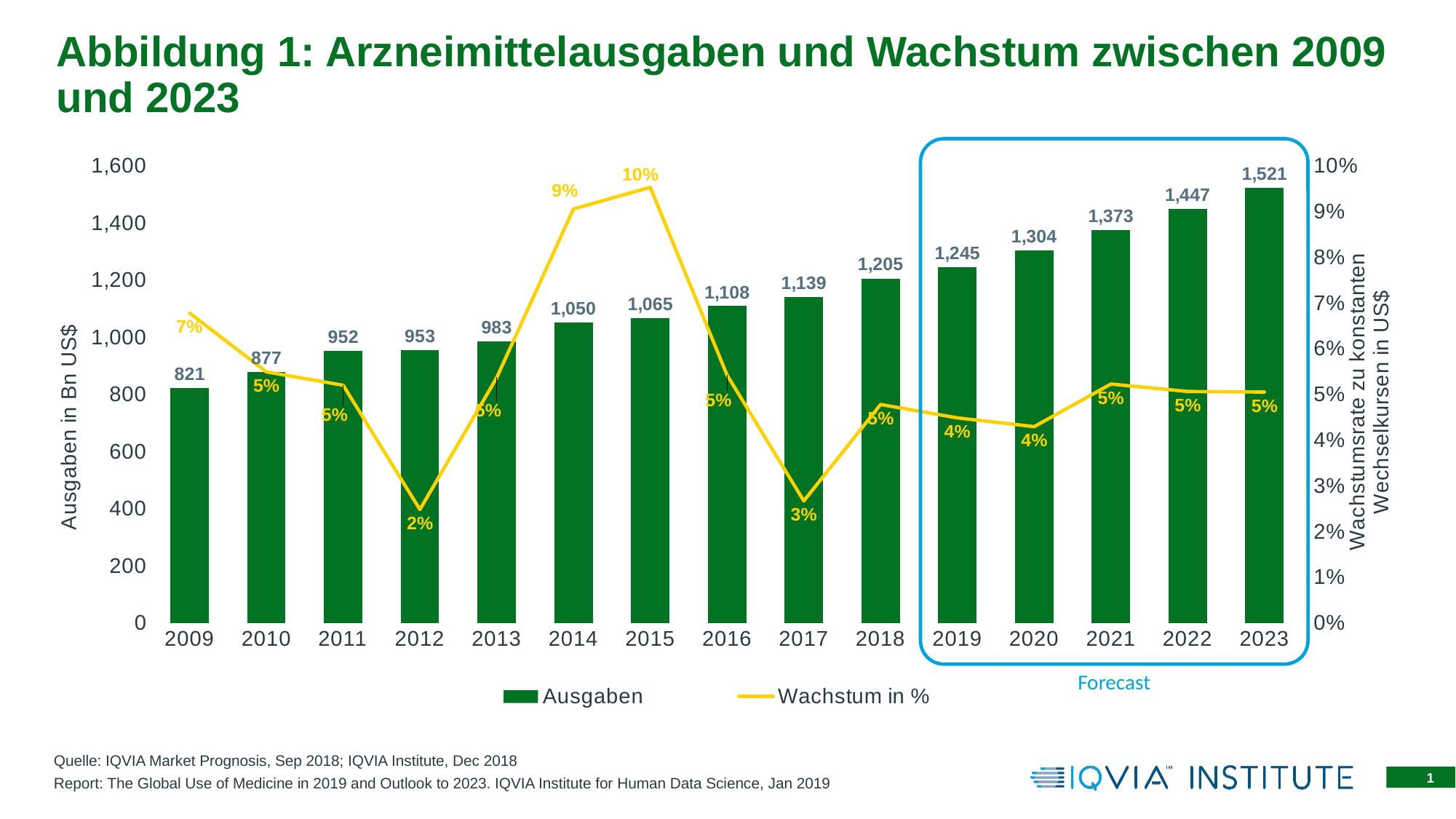
Which year has the highest Wachstum in % value? 2015 Which year has the lowest Ausgaben value? 2009 What is the Ausgaben value for 2023? 1,521 What is the difference between the Ausgaben values for 2023 and 2009? 700 Which years are enclosed in the box labelled Forecast? 2019 to 2023 Which is larger, the Ausgaben value for 2018 or for 2016? 2018 Do the Ausgaben values rise or fall from 2009 to 2023? rise How many years are shown on the x axis? 15 How many series does the legend list? 2 What is the Wachstum in % value for 2015? 10% What is the Ausgaben value for 2014? 1,050 Which year has the lowest Wachstum in % value? 2012